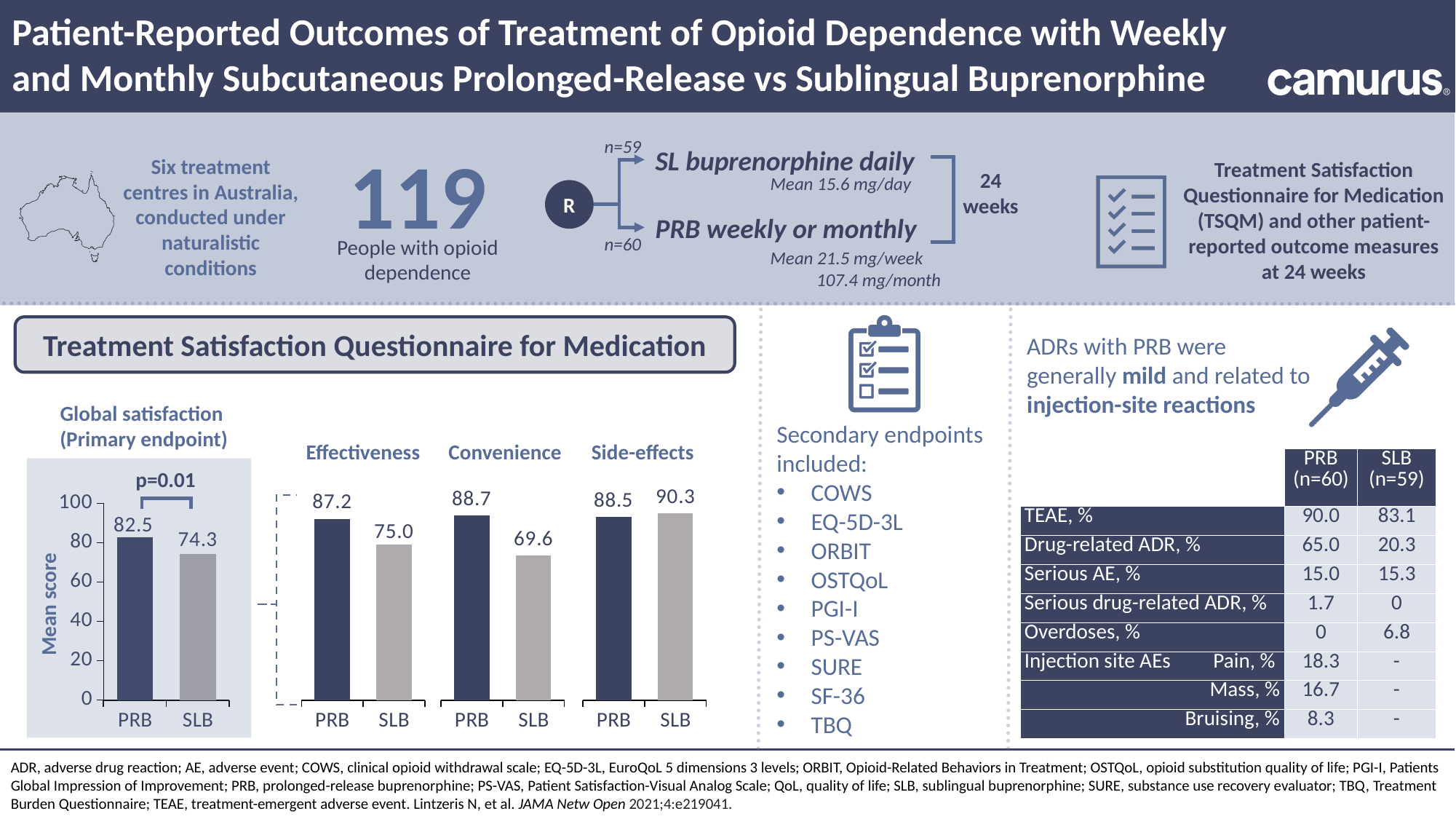
In the Convenience chart, what is the mean score for PRB? 88.7 In the Side-effects chart, what is the mean score for SLB? 90.3 How many bars are shown in the Convenience chart? 2 In the Effectiveness chart, which group has the higher mean score, PRB or SLB? PRB In the Convenience chart, what is the difference between the PRB and SLB mean scores? 19.1 What type of chart is used for the Global satisfaction (Primary endpoint) data? Bar chart What is the y-axis label of the Global satisfaction (Primary endpoint) chart? Mean score In the Effectiveness chart, what is the mean score for SLB? 75.0 In the Global satisfaction (Primary endpoint) chart, what is the mean score for PRB? 82.5 In the Global satisfaction (Primary endpoint) chart, what is the mean score for SLB? 74.3 In the Side-effects chart, which group has the higher mean score, PRB or SLB? SLB In the Global satisfaction (Primary endpoint) chart, what is the difference between the PRB and SLB mean scores? 8.2